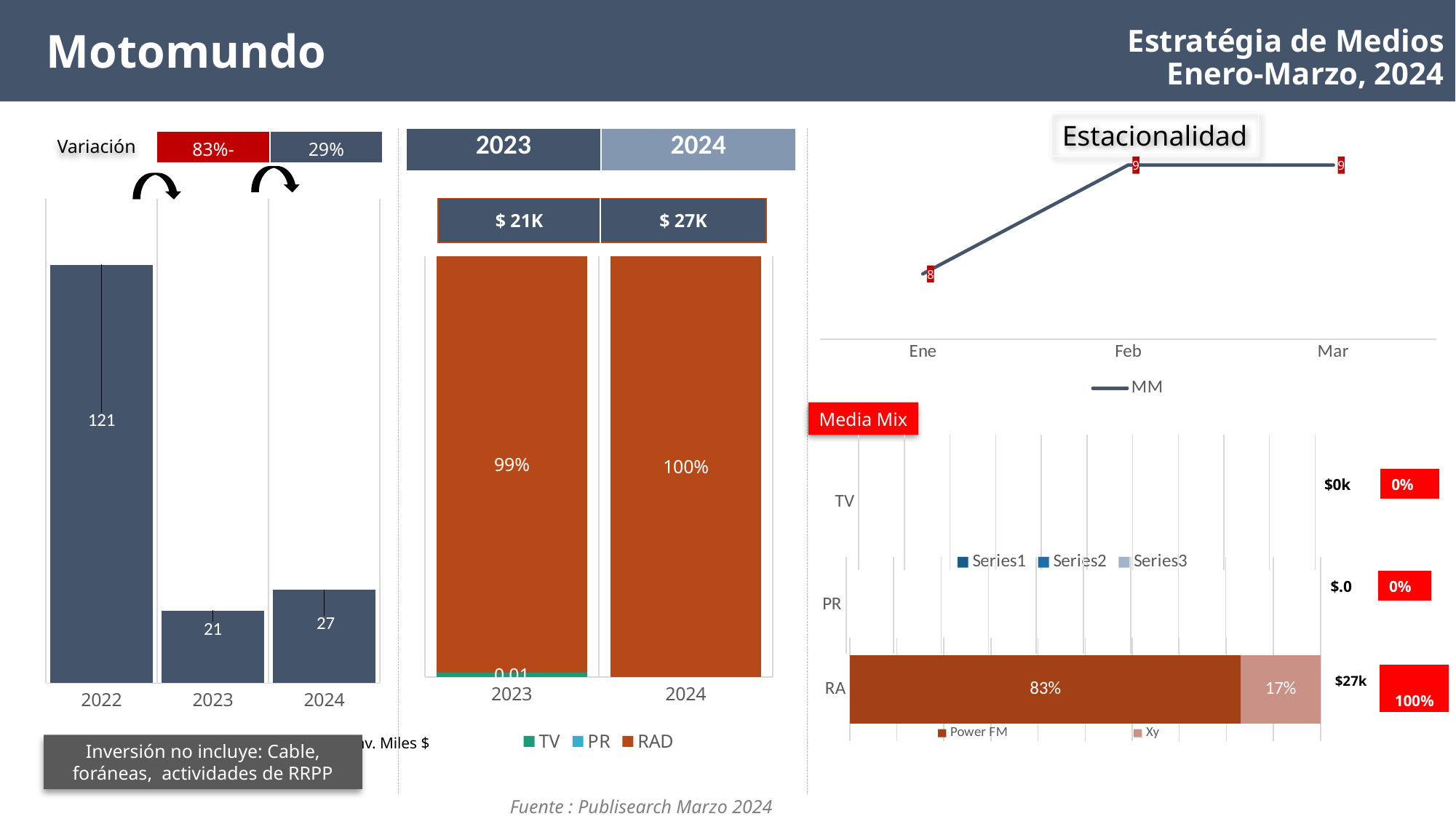
In the middle stacked bar chart, how many series does the legend list? 3 In the left bar chart, which year has the lowest value? 2023 In the middle stacked bar chart, what share does RAD have in 2024? 100% In the middle stacked bar chart, what share does RAD have in 2023? 99% In the left bar chart, what is the value for 2022? 121 In the left bar chart, how many years are shown? 3 In the Estacionalidad line chart, do the values rise or fall from Ene to Feb? rise In the left bar chart, what is the difference between the values for 2022 and 2024? 94 In the Media Mix chart, what share of the RA bar is Power FM? 83% In the left bar chart, what is the value for 2023? 21 In the left bar chart, which year has the highest value? 2022 In the Estacionalidad line chart, what is the value for Ene? 8